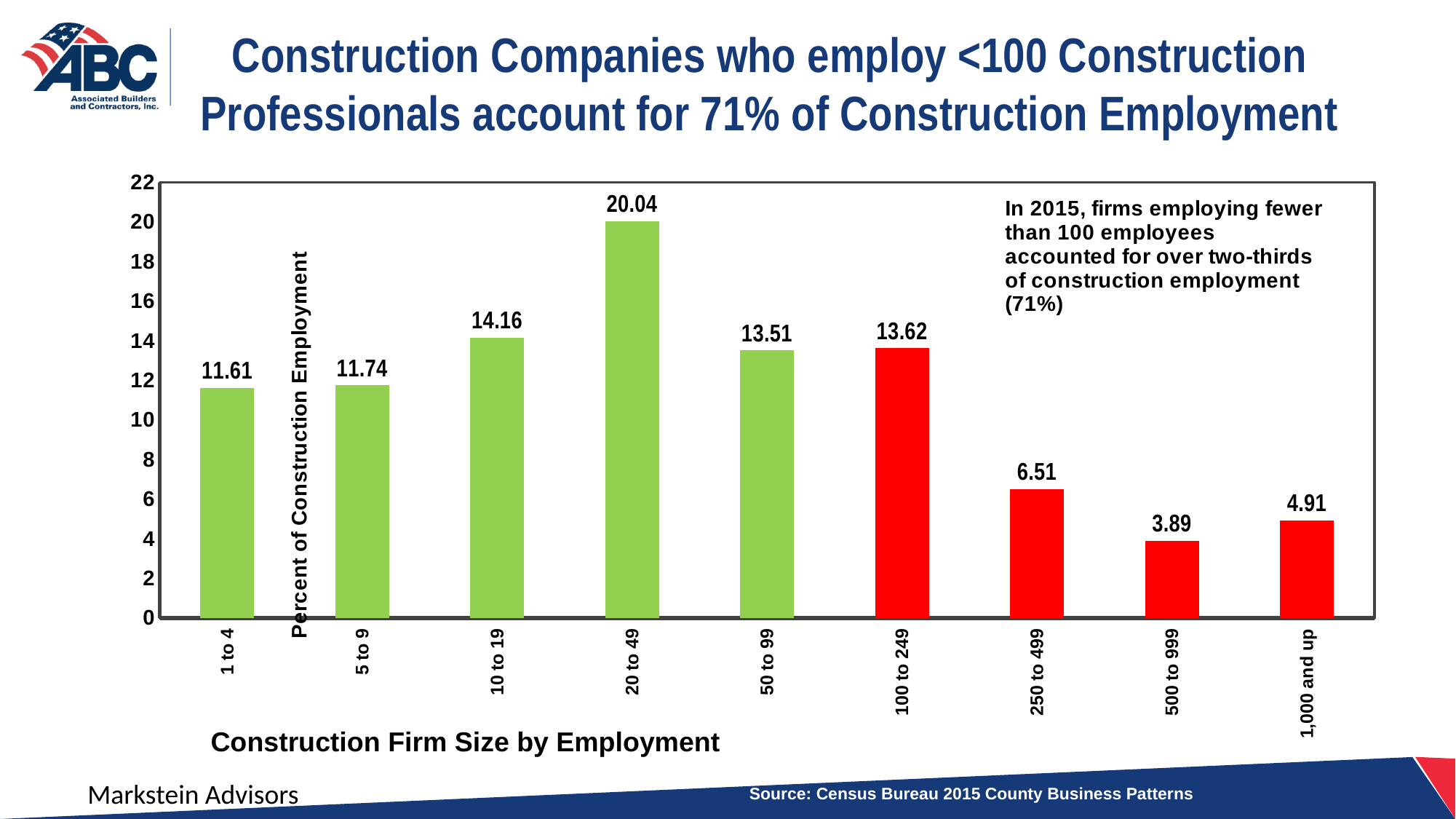
How many firm size categories are shown on the x axis? 9 Which firm size category has the highest percent of construction employment? 20 to 49 What is the value for the 1,000 and up firm size category? 4.91 What is the value for the 500 to 999 firm size category? 3.89 What is the difference between the values for 250 to 499 and 1,000 and up? 1.6 What is the value for the 20 to 49 firm size category? 20.04 What kind of chart is shown on the slide? bar chart What is the difference between the values for 20 to 49 and 10 to 19? 5.88 Which is larger, the value for 1 to 4 or the value for 5 to 9? 5 to 9 What is the x-axis title of the chart? Construction Firm Size by Employment Which firm size category has the lowest percent of construction employment? 500 to 999 Is the value for 100 to 249 greater or less than 12? greater